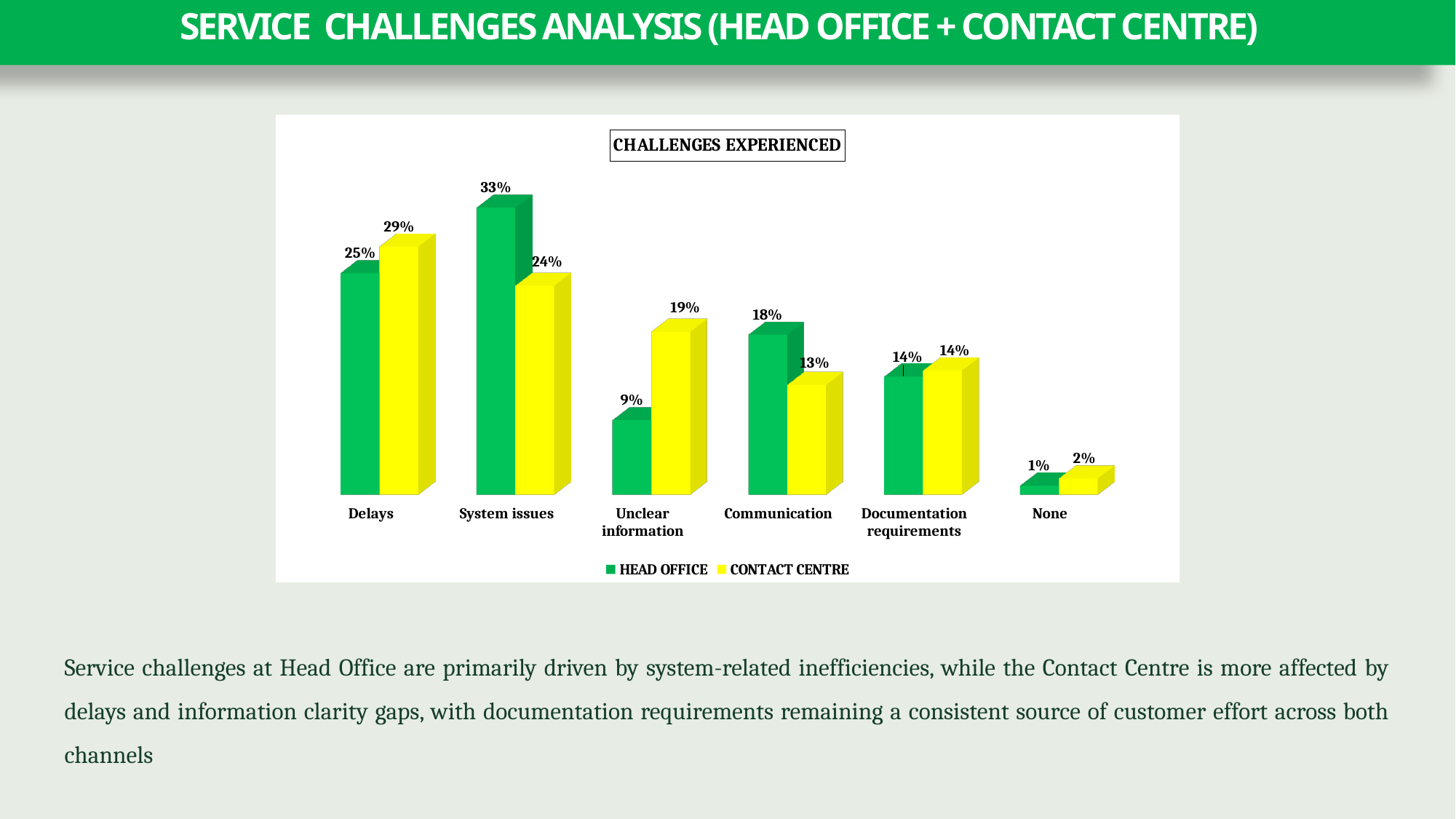
What is the HEAD OFFICE value for Communication? 18% What is the title of the chart? CHALLENGES EXPERIENCED What is the CONTACT CENTRE value for Unclear information? 19% What is the HEAD OFFICE value for System issues? 33% Which category has the lowest CONTACT CENTRE value? None What is the difference between the CONTACT CENTRE and HEAD OFFICE values for Delays? 4% How many categories are shown on the x axis? 6 How many series does the legend list? 2 What is the difference between the HEAD OFFICE and CONTACT CENTRE values for Unclear information? 10% What kind of chart is shown? Bar chart Which category has the highest HEAD OFFICE value? System issues For Communication, which series has the larger value, HEAD OFFICE or CONTACT CENTRE? HEAD OFFICE